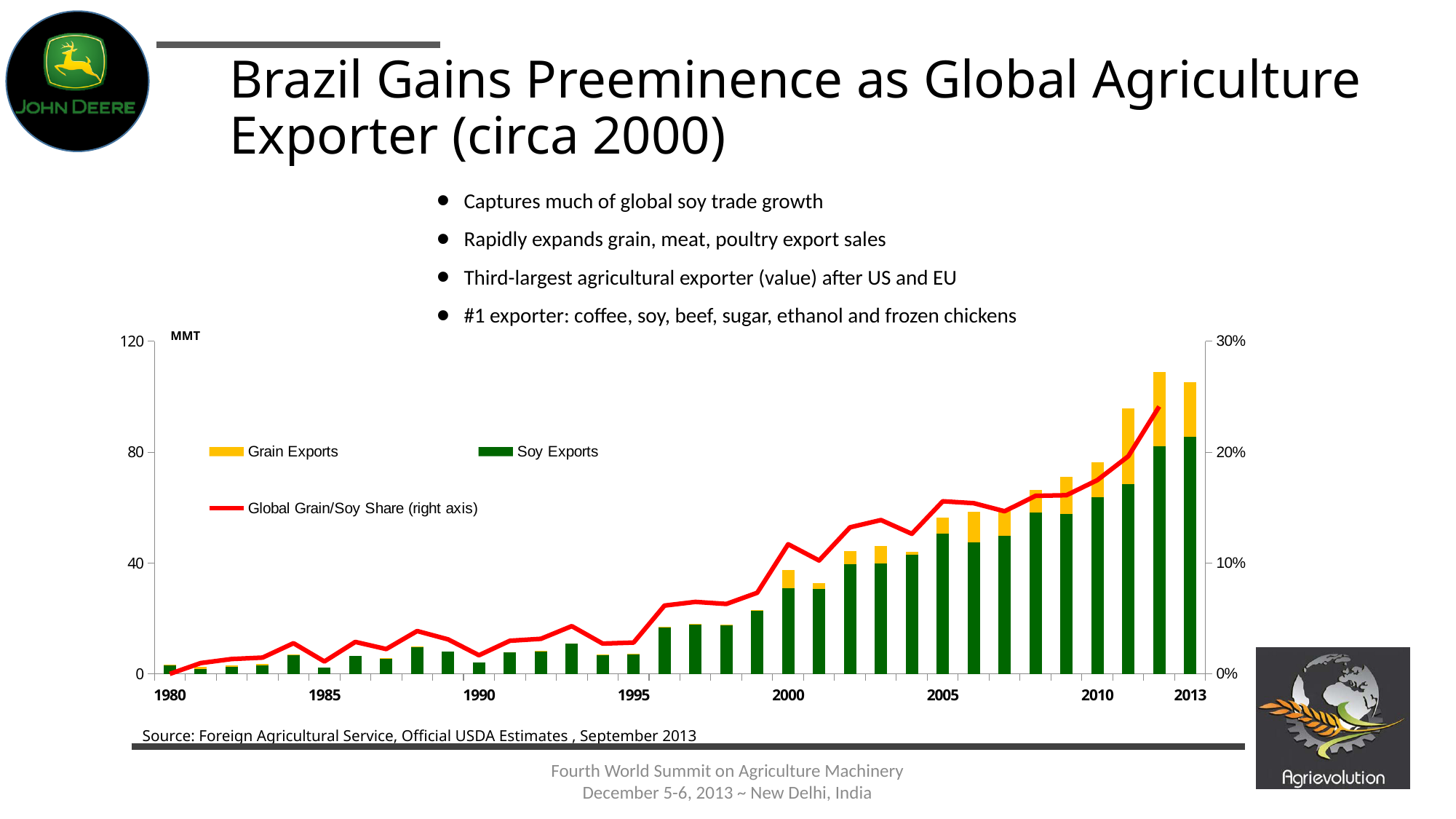
Is the Global Grain/Soy Share for 2012 greater or less than 20%? greater What kind of chart is shown on the slide? Stacked bar chart with a line How many series does the chart legend list? 3 Which year has the tallest stacked bar (highest combined grain and soy exports)? 2012 Is the combined grain and soy export bar for 2005 greater or less than 40 MMT? greater Which series is plotted on the right axis? Global Grain/Soy Share Is the Global Grain/Soy Share for 1995 greater or less than 10%? less Do Brazil's combined grain and soy exports generally rise or fall from 1980 to 2013? rise What unit is shown on the left axis of the chart? MMT Which year has the larger combined export bar, 2010 or 2011? 2011